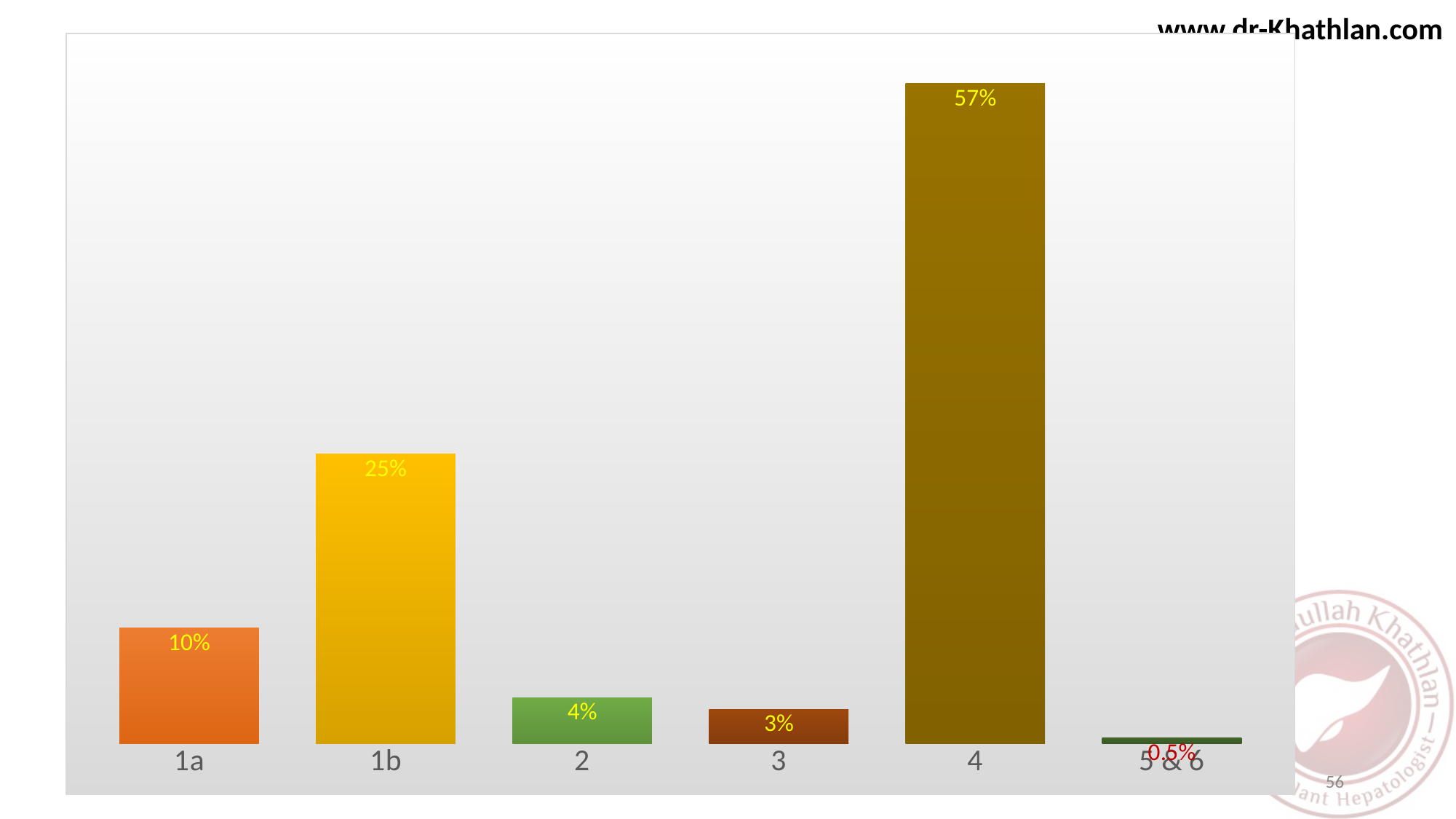
What is the difference between the values for category 4 and category 1b? 32% Which category has the highest value? 4 What is the value for category 1a? 10% What colour is the bar for category 2? Green Which category has the lowest value? 5 & 6 What is the value for category 5 & 6? 0.5% What kind of chart is shown on the slide? Bar chart What is the difference between the values for category 1a and category 2? 6% How many categories are shown on the x axis? 6 What is the value for category 4? 57% Which is larger, the value for category 2 or the value for category 3? 2 What is the value for category 1b? 25%